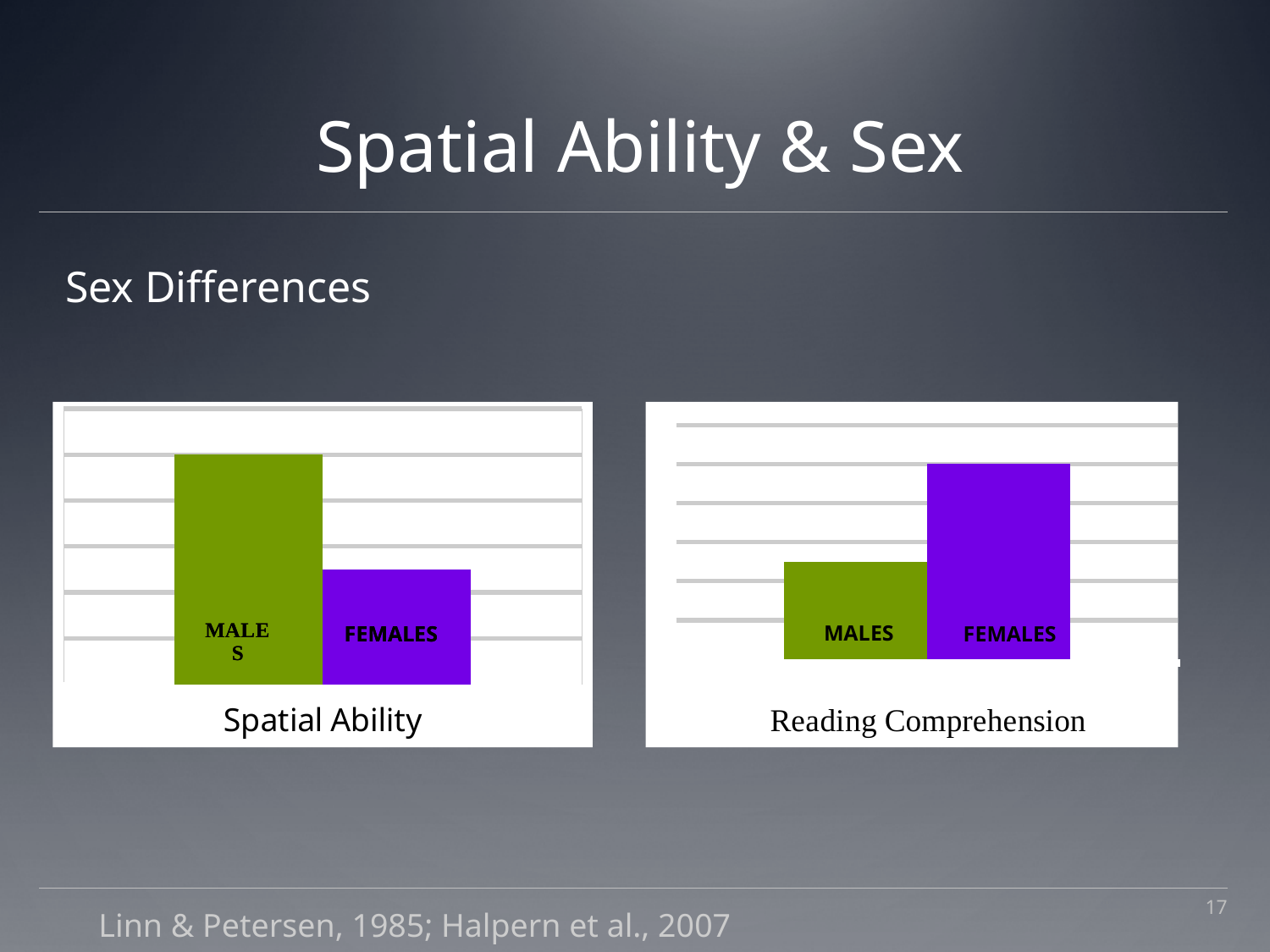
In the Reading Comprehension chart, which category has the shorter bar? Males In the Reading Comprehension chart, which category has the taller bar? Females In the Spatial Ability chart, is the bar for Males or Females larger? Males How many bars are shown in the Spatial Ability chart? 2 In the Spatial Ability chart, which category has the shorter bar? Females How many bars are shown in the Reading Comprehension chart? 2 What kind of chart is the Spatial Ability chart? Bar chart In the Reading Comprehension chart, is the bar for Males or Females larger? Females What is the title of the chart on the right side of the slide? Reading Comprehension In the Spatial Ability chart, which category has the taller bar? Males What kind of chart is the Reading Comprehension chart? Bar chart In the Spatial Ability chart, what colour is the Females bar? Purple